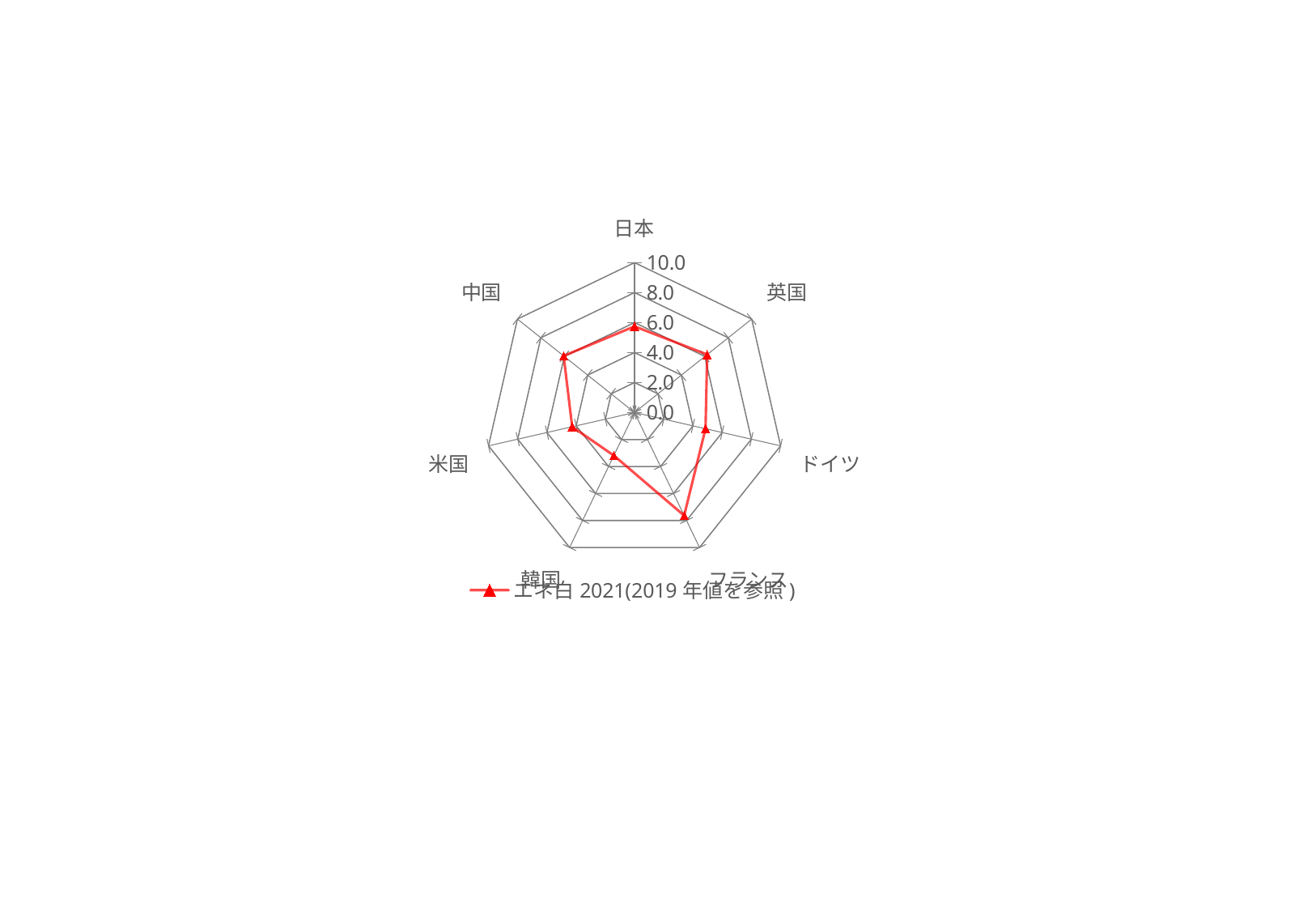
Is the value for 日本 greater or less than 4.0? greater Is the value for フランス greater or less than 6.0? greater Which is larger, the value for 日本 or the value for 韓国? 日本 Is the value for 韓国 greater or less than 4.0? less What kind of chart is shown on the slide? Radar chart How many categories (countries) are plotted on the radar chart? 7 How many series does the legend list? 1 What is the name of the series shown in the legend? エネ白 2021(2019年値を参照) Which country has the highest value on the radar chart? フランス Which is larger, the value for フランス or the value for 韓国? フランス Which country has the lowest value on the radar chart? 韓国